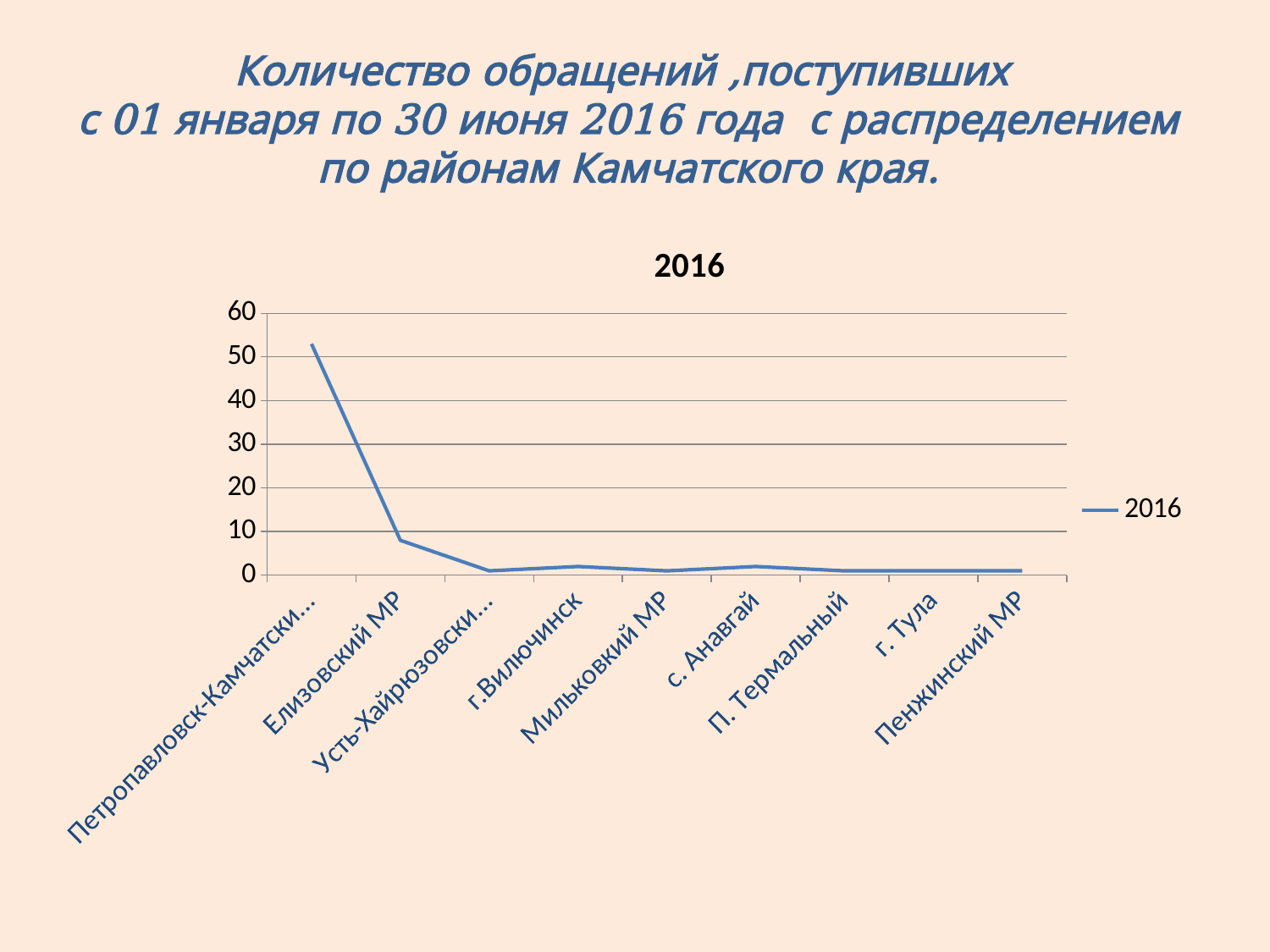
Is the value for Петропавловск-Камчатски... greater or less than 40? greater What is the name of the series in the legend? 2016 What is the title shown above the chart? 2016 Is the value for г.Вилючинск greater or less than 10? less Is the value for Елизовский МР greater or less than 10? less Which is larger, the value for Петропавловск-Камчатски... or the value for Елизовский МР? Петропавловск-Камчатски... How many categories (districts) are plotted along the x axis? 9 Which is larger, the value for Елизовский МР or the value for Пенжинский МР? Елизовский МР Do the values generally rise or fall moving from left to right along the x axis? fall Which category has the highest value? Петропавловск-Камчатски... What kind of chart is shown on the slide? line chart How many series does the legend list? 1